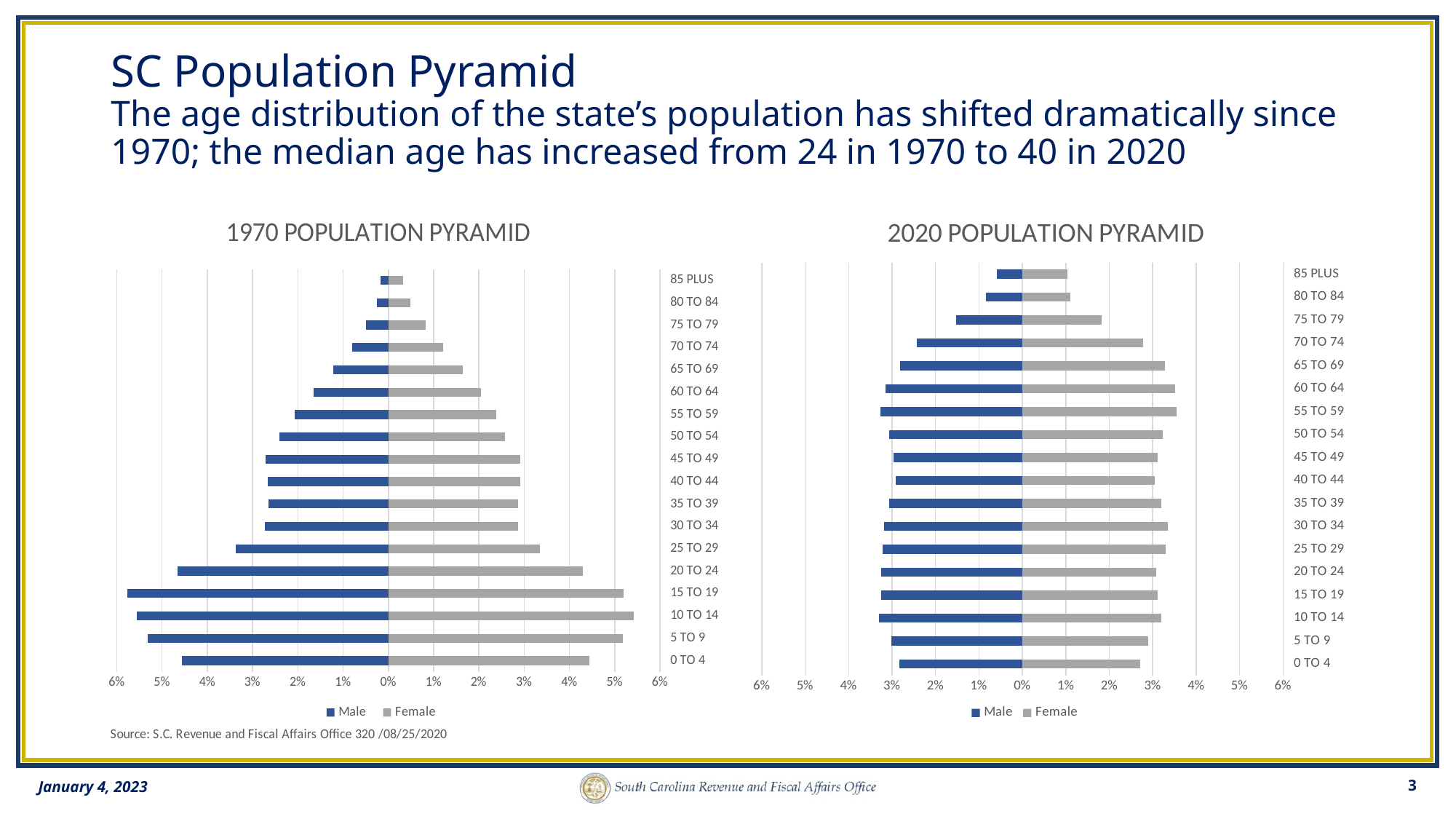
In the 1970 Population Pyramid, is the Female value for 0 TO 4 greater or less than 4%? greater How many series does the legend of the 1970 Population Pyramid list? 2 In the 1970 Population Pyramid, which colour represents the Male series? Blue In the 2020 Population Pyramid, which age group has the smallest Male value? 85 PLUS How many age groups are shown in the 2020 Population Pyramid? 18 In the 1970 Population Pyramid, which age group has the smallest Male value? 85 PLUS What kind of chart is the 1970 Population Pyramid? Bar chart In the 1970 Population Pyramid, is the Male value for 15 TO 19 greater or less than 5%? greater In the 1970 Population Pyramid, which is larger, the Male value for 20 TO 24 or for 25 TO 29? 20 TO 24 In the 2020 Population Pyramid, is the Female value for 55 TO 59 greater or less than 3%? greater In the 2020 Population Pyramid, which is larger, the Female value for 70 TO 74 or for 75 TO 79? 70 TO 74